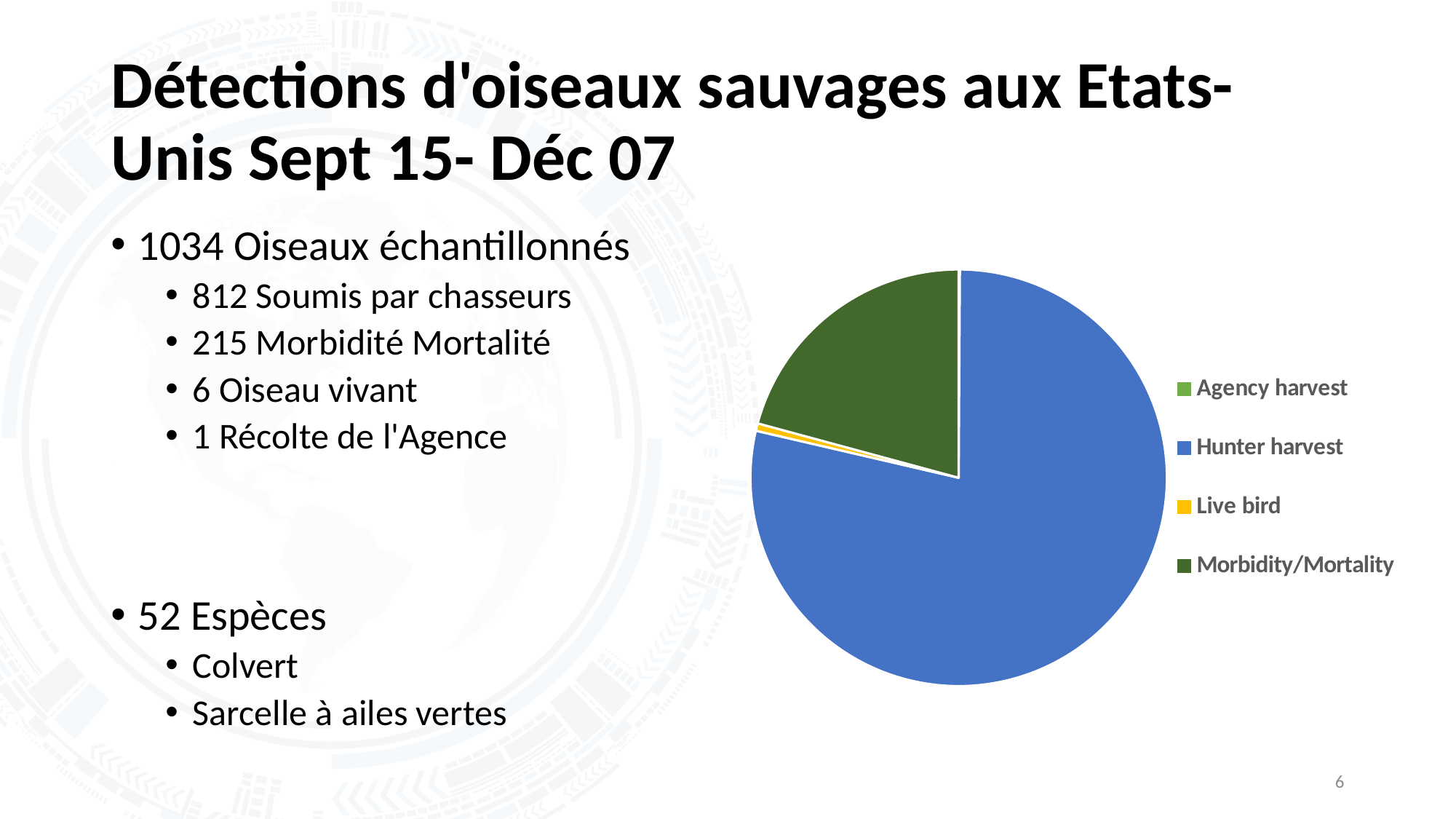
What colour is the Live bird slice in the pie chart? yellow What colour is the Hunter harvest slice in the pie chart? blue How many categories does the pie chart's legend list? 4 Which slice is larger in the pie chart, Morbidity/Mortality or Live bird? Morbidity/Mortality Is the Hunter harvest share of the pie chart greater or less than 50%? greater Which category has the largest slice of the pie chart? Hunter harvest What kind of chart is shown on the slide? pie chart Is the Morbidity/Mortality share of the pie chart greater or less than 50%? less Which category has the smallest slice of the pie chart? Agency harvest Which slice is larger in the pie chart, Hunter harvest or Morbidity/Mortality? Hunter harvest